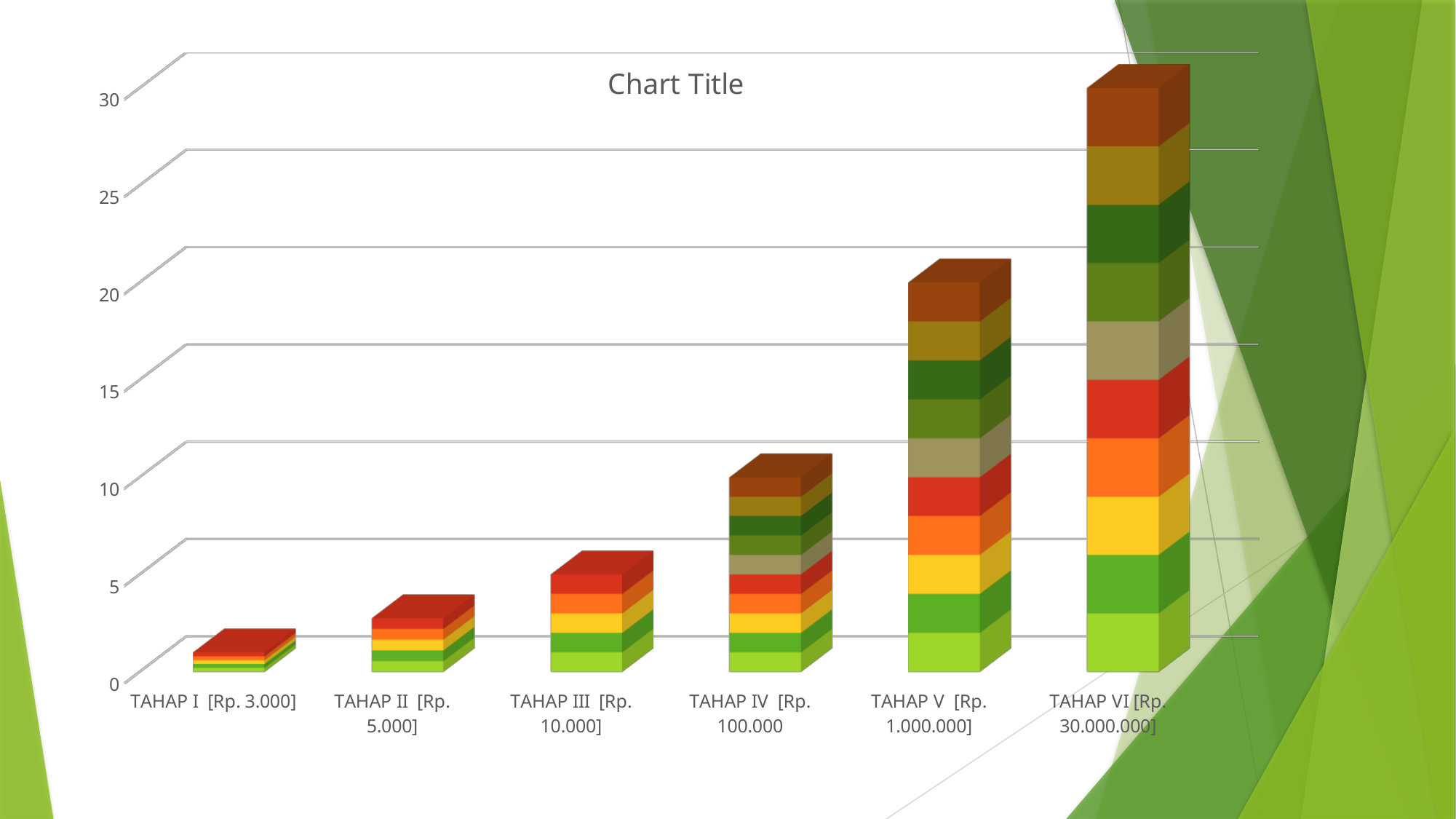
Do the bar totals rise or fall from TAHAP I to TAHAP VI along the x axis? Rise Which has the larger total, TAHAP III [Rp. 10.000] or TAHAP V [Rp. 1.000.000]? TAHAP V [Rp. 1.000.000] Is the total for TAHAP V [Rp. 1.000.000] greater or less than 15? greater Is the total for TAHAP I [Rp. 3.000] greater or less than 5? less How many categories are shown on the x axis of the chart? 6 Does the chart display a legend? No Is the total for TAHAP VI [Rp. 30.000.000] greater or less than 25? greater Which category has the shortest stacked bar? TAHAP I [Rp. 3.000] What is the title of the chart? Chart Title What kind of chart is shown on the slide? Stacked bar chart Which category has the tallest stacked bar? TAHAP VI [Rp. 30.000.000]